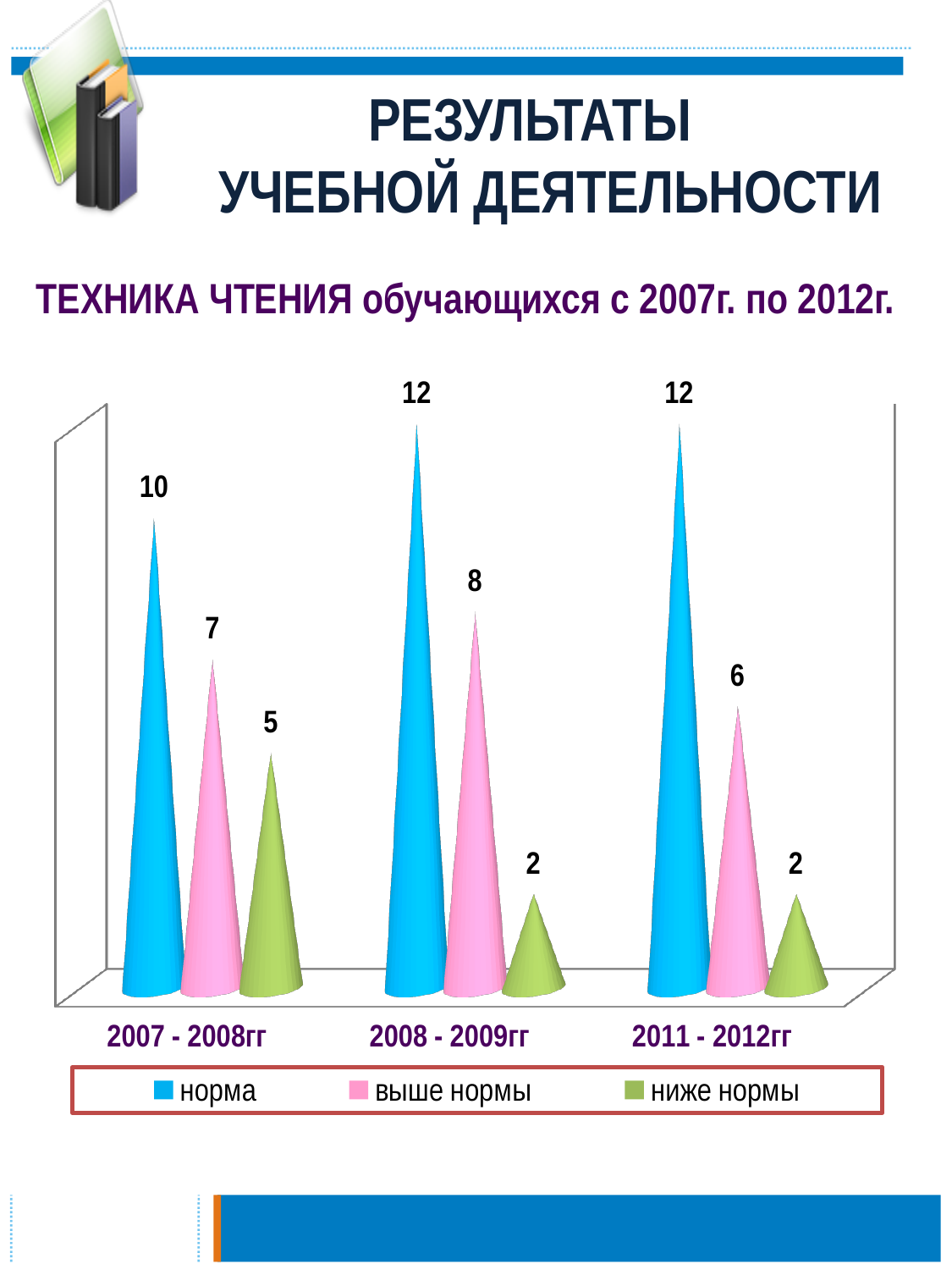
What is the difference between "норма" and "ниже нормы" in 2008 - 2009гг? 10 What is the value for "ниже нормы" in 2011 - 2012гг? 2 What kind of chart is shown on the slide? bar chart How many series does the legend list? 3 What is the value for "норма" in 2007 - 2008гг? 10 How many periods are shown on the x axis? 3 Which is larger in 2007 - 2008гг: "выше нормы" or "ниже нормы"? выше нормы What is the value for "выше нормы" in 2011 - 2012гг? 6 In which period is the value for "ниже нормы" highest? 2007 - 2008гг In which period is the value for "норма" lowest? 2007 - 2008гг Does the value for "ниже нормы" rise or fall from 2007 - 2008гг to 2011 - 2012гг? fall What is the value for "выше нормы" in 2008 - 2009гг? 8